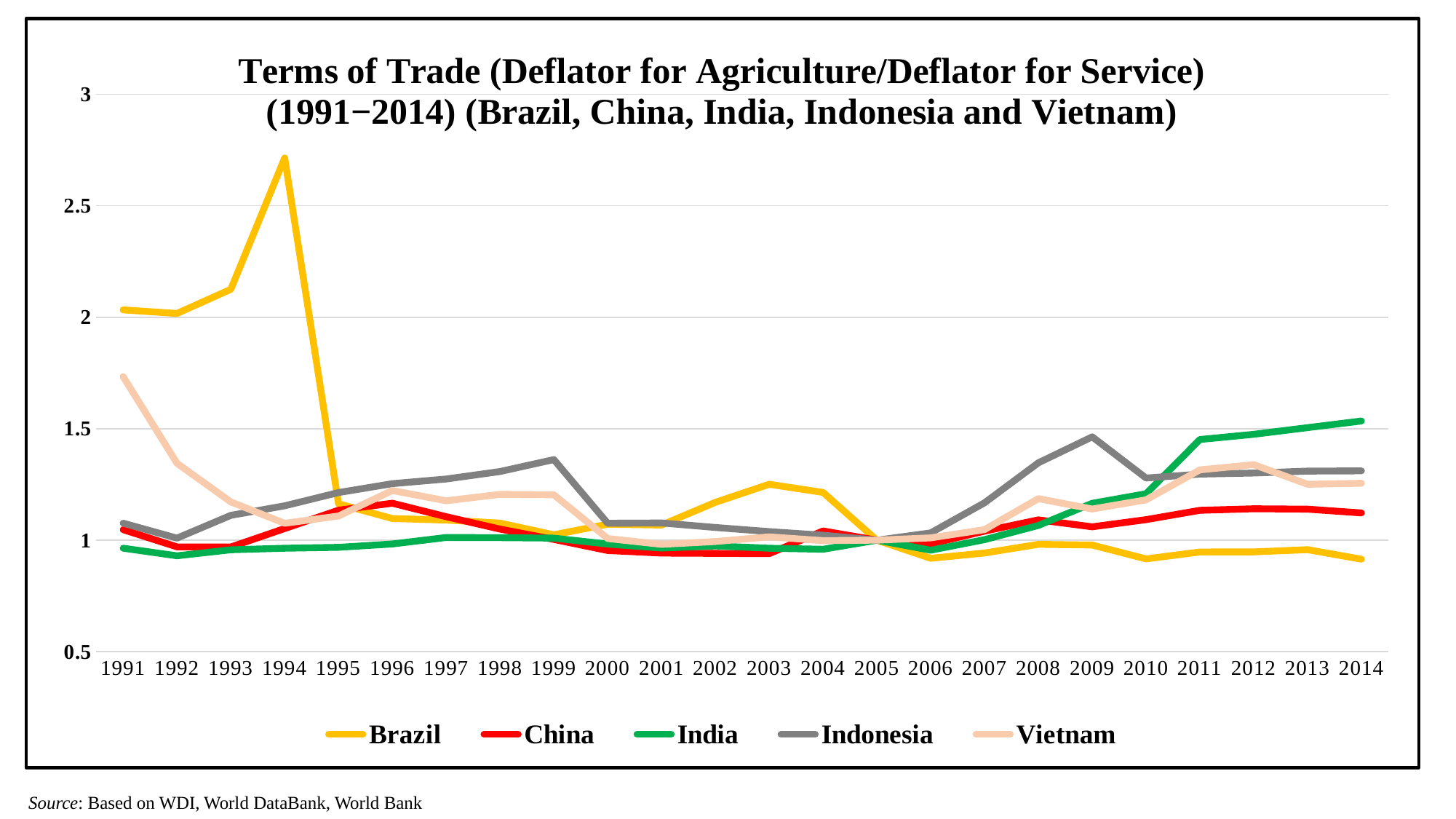
Which is larger in 1991, the value for Brazil or the value for Vietnam? Brazil Which country has the lowest value in 2014? Brazil Which country has the highest value in 1994? Brazil Which country has the highest value in 1999? Indonesia Is the value for Vietnam in 1991 greater or less than 1.5? greater How many series does the legend list? 5 What kind of chart is shown on the slide? line chart Is the value for Brazil in 1994 greater or less than 2.5? greater How many years are plotted along the x axis? 24 Does the value for India rise or fall from 2005 to 2014? rise Is the value for Brazil in 2010 greater or less than 1? less Which country has the highest value in 2014? India